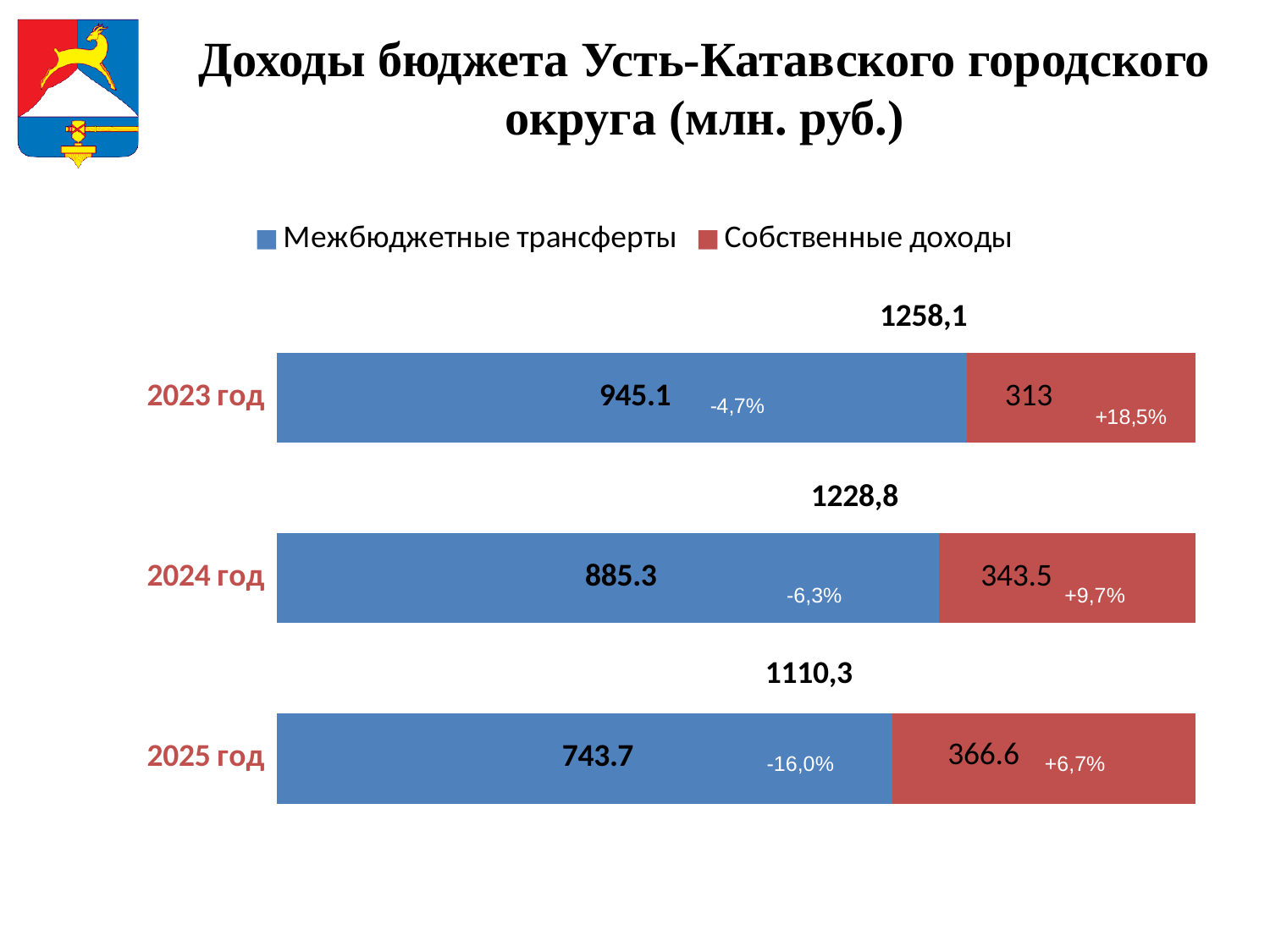
What is the value of Собственные доходы for 2024 год? 343.5 What is the value of Межбюджетные трансферты for 2023 год? 945.1 Which year has the highest value of Межбюджетные трансферты? 2023 год What is the total shown above the bar for 2024 год? 1228,8 What is the difference between Межбюджетные трансферты in 2023 год and 2025 год? 201.4 What is the total shown above the bar for 2025 год? 1110,3 How many years are shown on the chart? 3 How many series does the legend list? 2 What kind of chart is shown on the slide? Stacked bar chart What is the value of Собственные доходы for 2025 год? 366.6 Which year has the lowest value of Собственные доходы? 2023 год Which is larger: Собственные доходы in 2024 год or in 2025 год? 2025 год